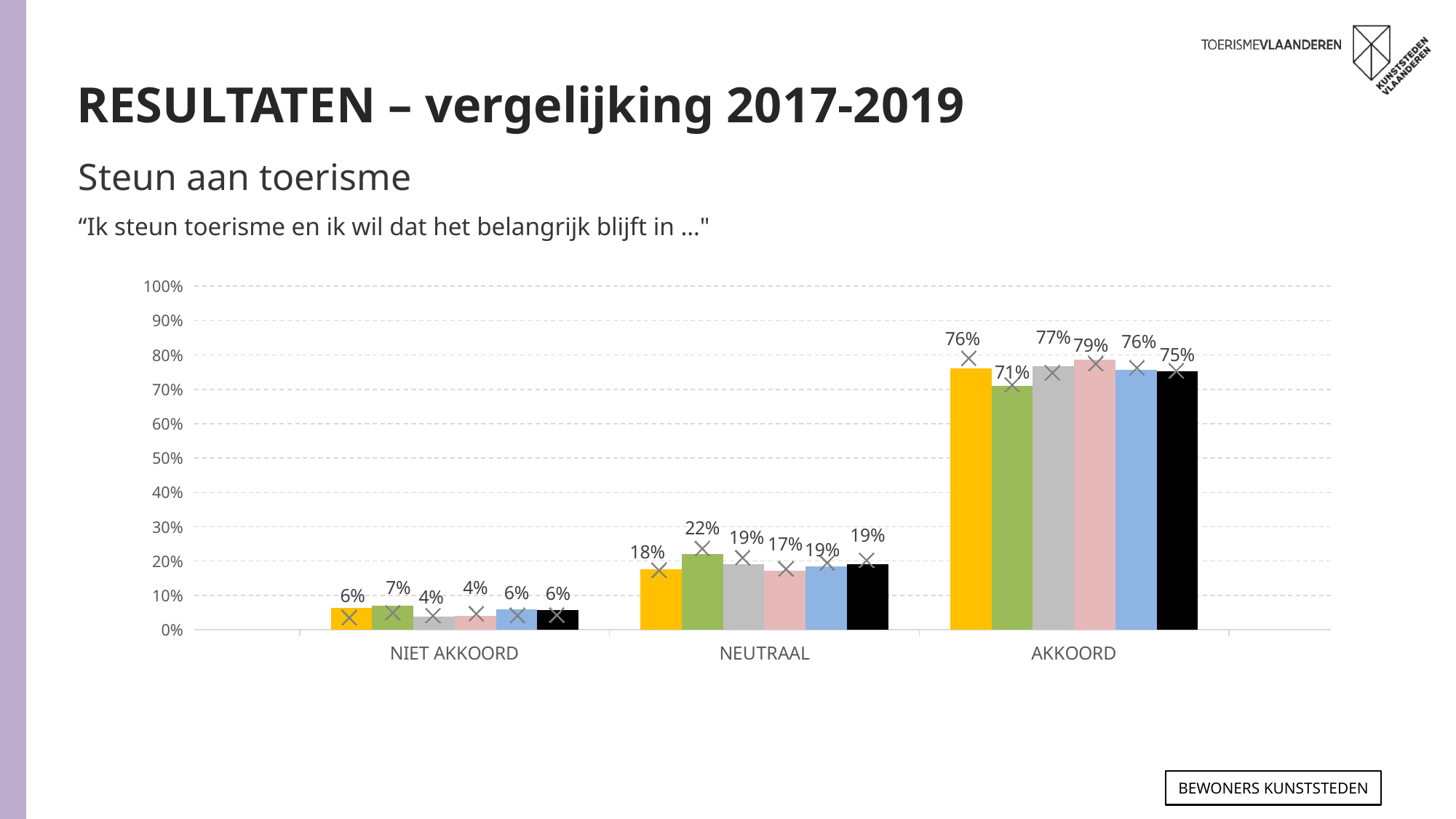
What is the value of the green bar in the NEUTRAAL category? 22% What is the value of the yellow bar in the AKKOORD category? 76% What is the title of the chart section on the slide? Steun aan toerisme Which bar in the AKKOORD category has the lowest value? the green bar (71%) What is the value of the black bar in the NIET AKKOORD category? 6% Which is larger in the NEUTRAAL category: the green bar or the pink bar? the green bar What is the difference between the pink bar and the green bar in the AKKOORD category? 8% Which category has the highest values overall? AKKOORD How many bars are plotted for the AKKOORD category? 6 What kind of chart is shown on the slide? bar chart How many categories are shown on the x axis of the chart? 3 What is the value of the pink bar in the AKKOORD category? 79%